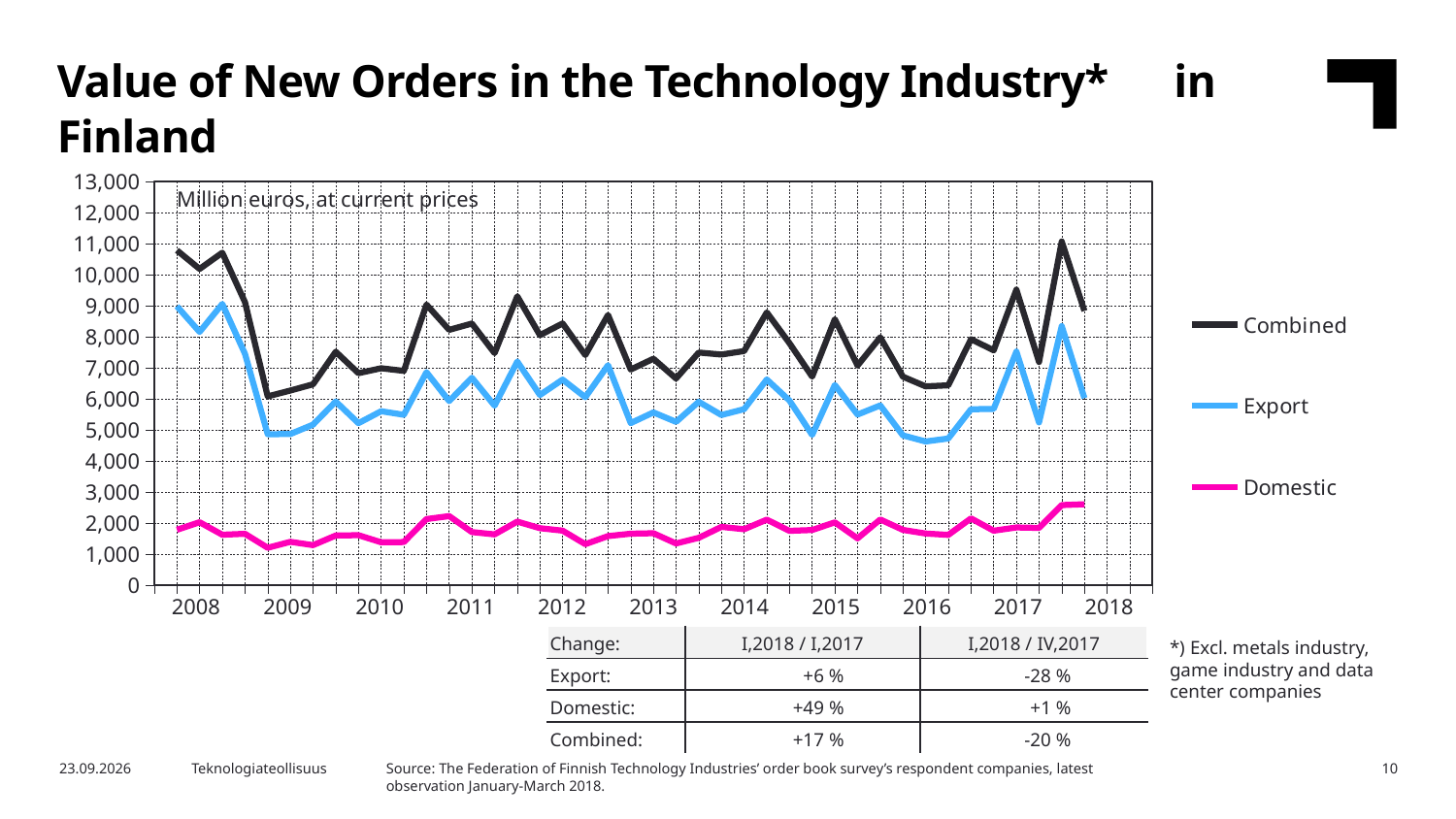
Which series has the lowest values throughout the chart? Domestic What kind of chart is shown on the slide? Line chart Which series has the highest values throughout the chart? Combined How many year labels are shown on the x axis? 11 Does the Combined series rise or fall from the start of 2008 to the start of 2009? Fall What unit note is printed inside the chart area? Million euros, at current prices Is the peak value for Combined in 2017 greater or less than 10,000? greater Is the value for Domestic at the start of 2008 greater or less than 3,000? less Is the value for Combined at the start of 2008 greater or less than 10,000? greater How many series does the chart legend list? 3 Which is larger at the start of 2018, the Combined value or the Export value? Combined